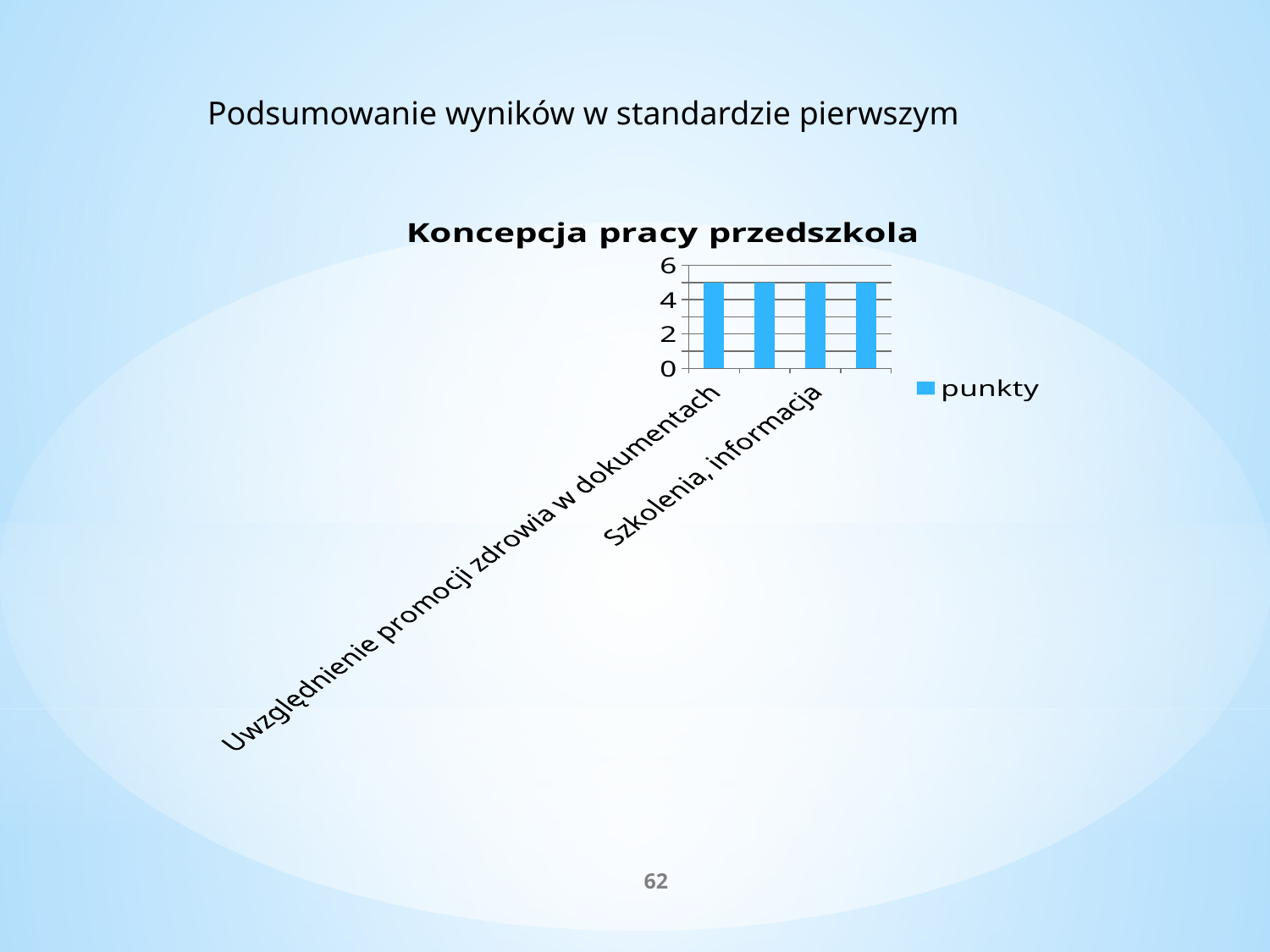
Is the value for 'Szkolenia, informacja' greater or less than 2? greater How many bars are plotted in the chart? 4 What kind of chart is shown on the slide? bar chart Are the bars for 'Uwzględnienie promocji zdrowia w dokumentach' and 'Szkolenia, informacja' the same height? yes How many series does the chart legend list? 1 What is the title of the chart? Koncepcja pracy przedszkola Is the value for 'Szkolenia, informacja' greater or less than 6? less Is the value for 'Uwzględnienie promocji zdrowia w dokumentach' greater or less than 4? greater What is the name of the series shown in the legend? punkty Do the bar values rise, fall, or stay the same across the categories? stay the same